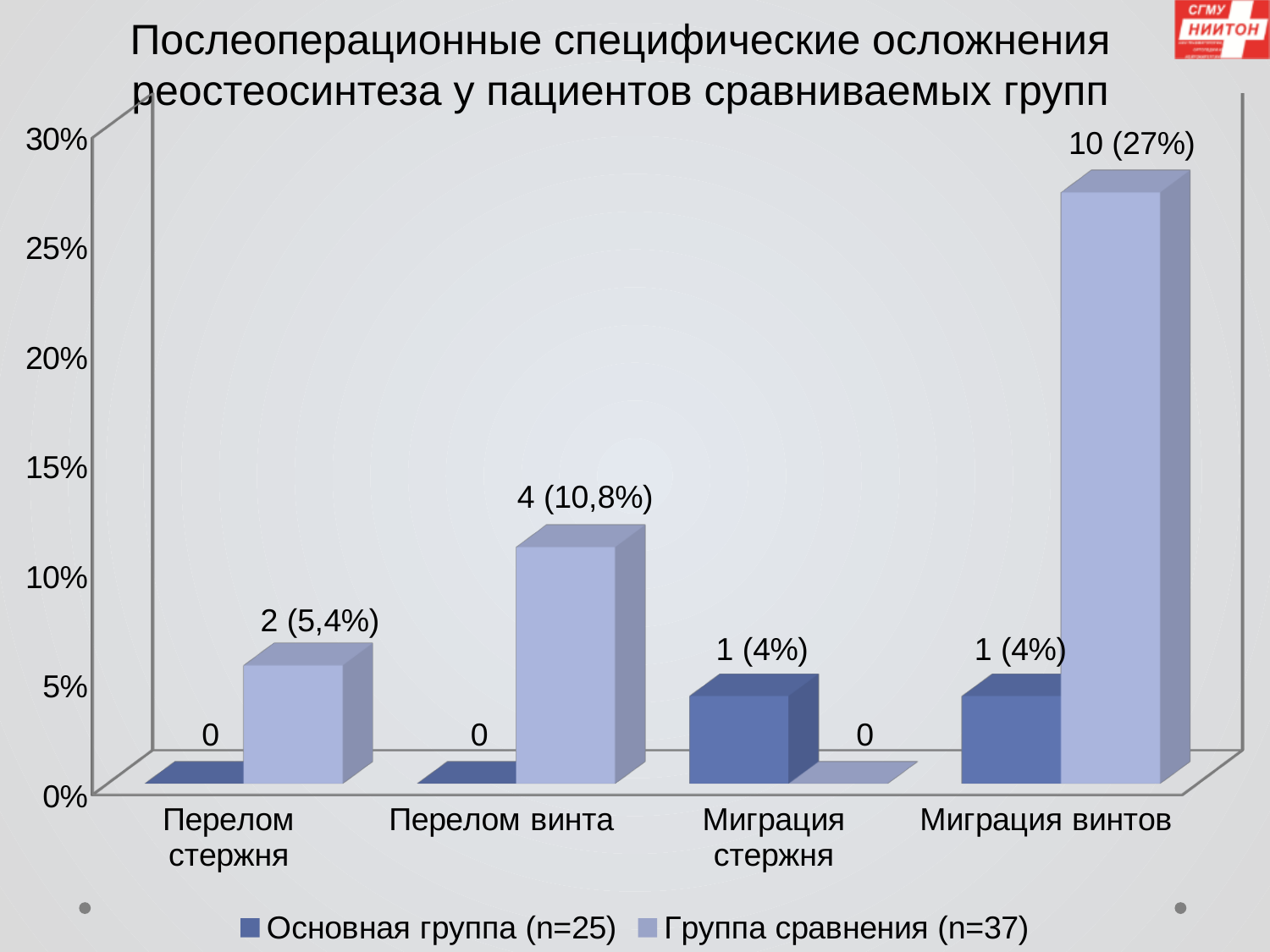
Which category has the highest value for Группа сравнения (n=37)? Миграция винтов Is the percentage for Группа сравнения (n=37) in the Миграция винтов category greater or less than 25%? greater Which category has the highest value for Основная группа (n=25)? Миграция стержня and Миграция винтов (both 1 (4%)) What is the value for Основная группа (n=25) in the Перелом винта category? 0 In the Миграция винтов category, which series has the larger value? Группа сравнения (n=37) What is the data label for Основная группа (n=25) in the Миграция стержня category? 1 (4%) What is the data label for Группа сравнения (n=37) in the Перелом винта category? 4 (10,8%) What is the data label for Группа сравнения (n=37) in the Миграция винтов category? 10 (27%) What type of chart is shown on the slide? Bar chart What is the data label for Группа сравнения (n=37) in the Перелом стержня category? 2 (5,4%) How many categories are shown on the x axis? 4 How many series does the legend list? 2